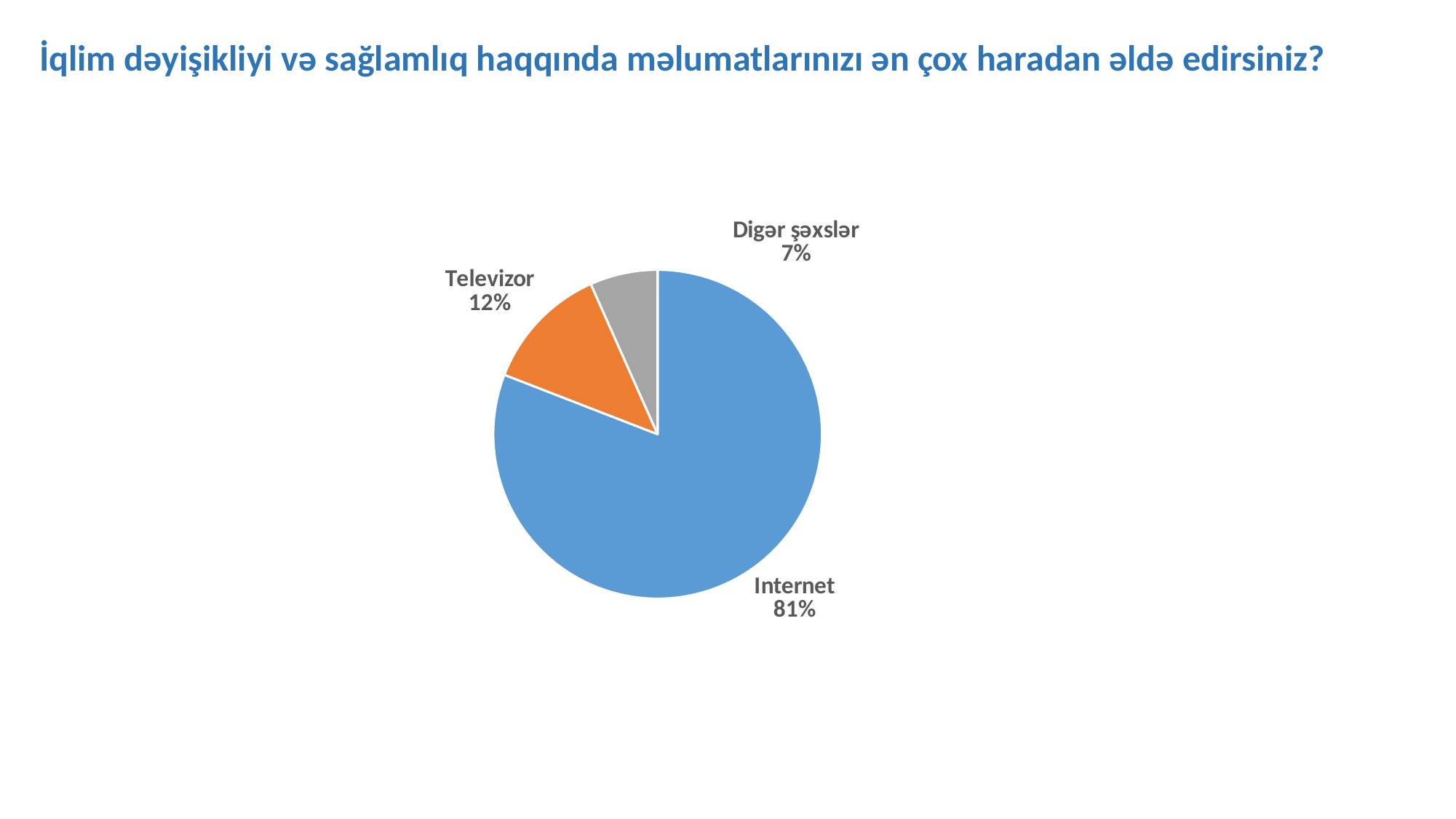
What share of the pie does Internet account for? 81% What is the value shown for Televizor? 12% Which category has the smallest slice of the pie? Digər şəxslər What is the difference in percentage points between Televizor and Digər şəxslər? 5 What is the value shown for Digər şəxslər? 7% What is the difference in percentage points between Internet and Televizor? 69 Which category has the largest slice of the pie? Internet What kind of chart is shown on the slide? Pie chart What colour is the Televizor slice? Orange What colour is the Internet slice? Blue Which is larger, the share for Televizor or the share for Digər şəxslər? Televizor How many categories are shown in the pie chart? 3